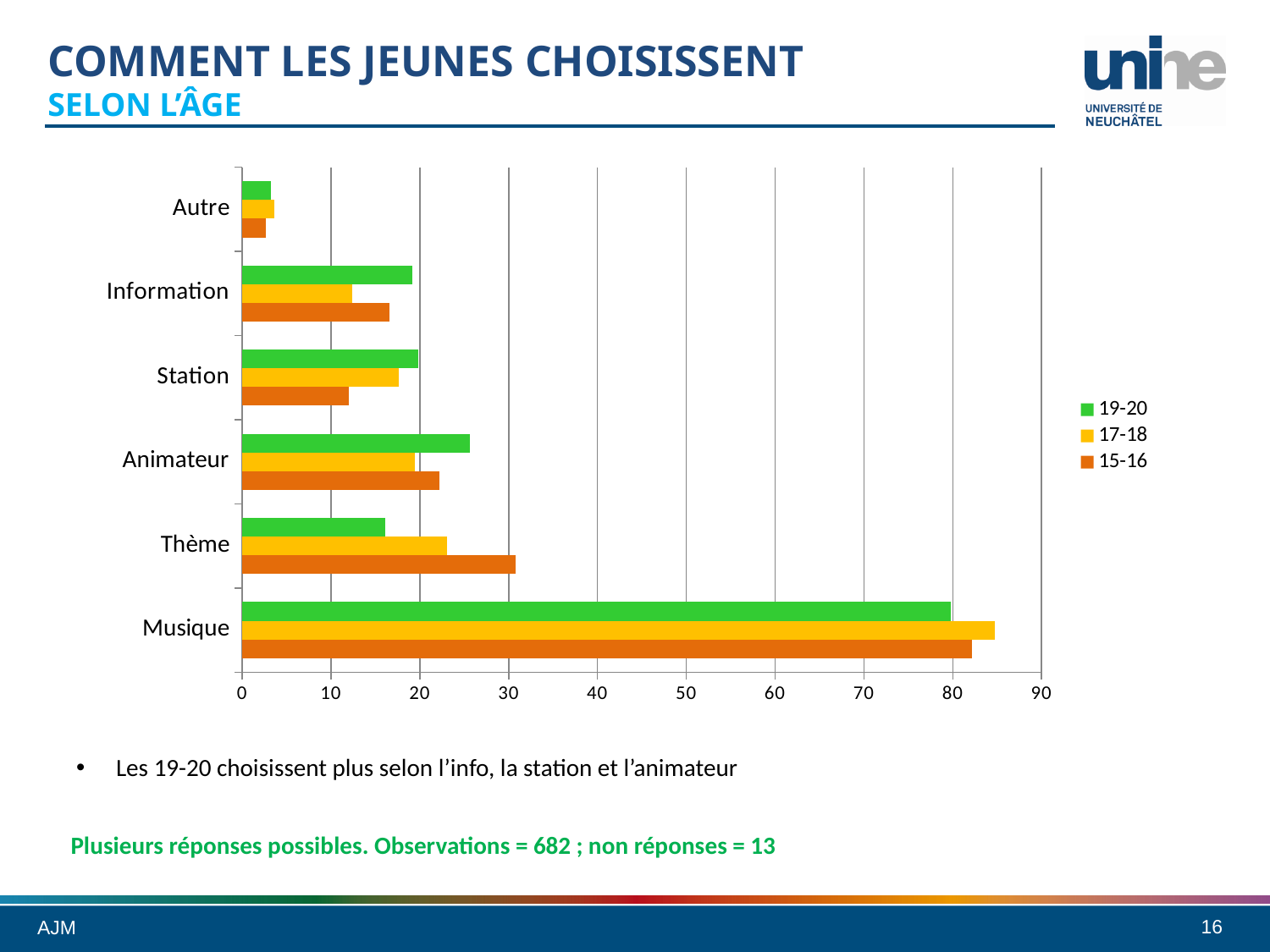
Which series is shown in green in the legend? 19-20 For Station, which series has the larger value: 19-20 or 15-16? 19-20 What kind of chart is shown on the slide? bar chart Which category has the highest value for the 19-20 series? Musique Is the value for Musique in the 17-18 series greater or less than 80? greater How many series does the chart's legend list? 3 Is the value for Thème in the 15-16 series greater or less than 20? greater Which category has the lowest value for the 15-16 series? Autre Is the value for Animateur in the 19-20 series greater or less than 20? greater For Thème, which series has the larger value: 15-16 or 19-20? 15-16 How many categories are shown on the chart's vertical axis? 6